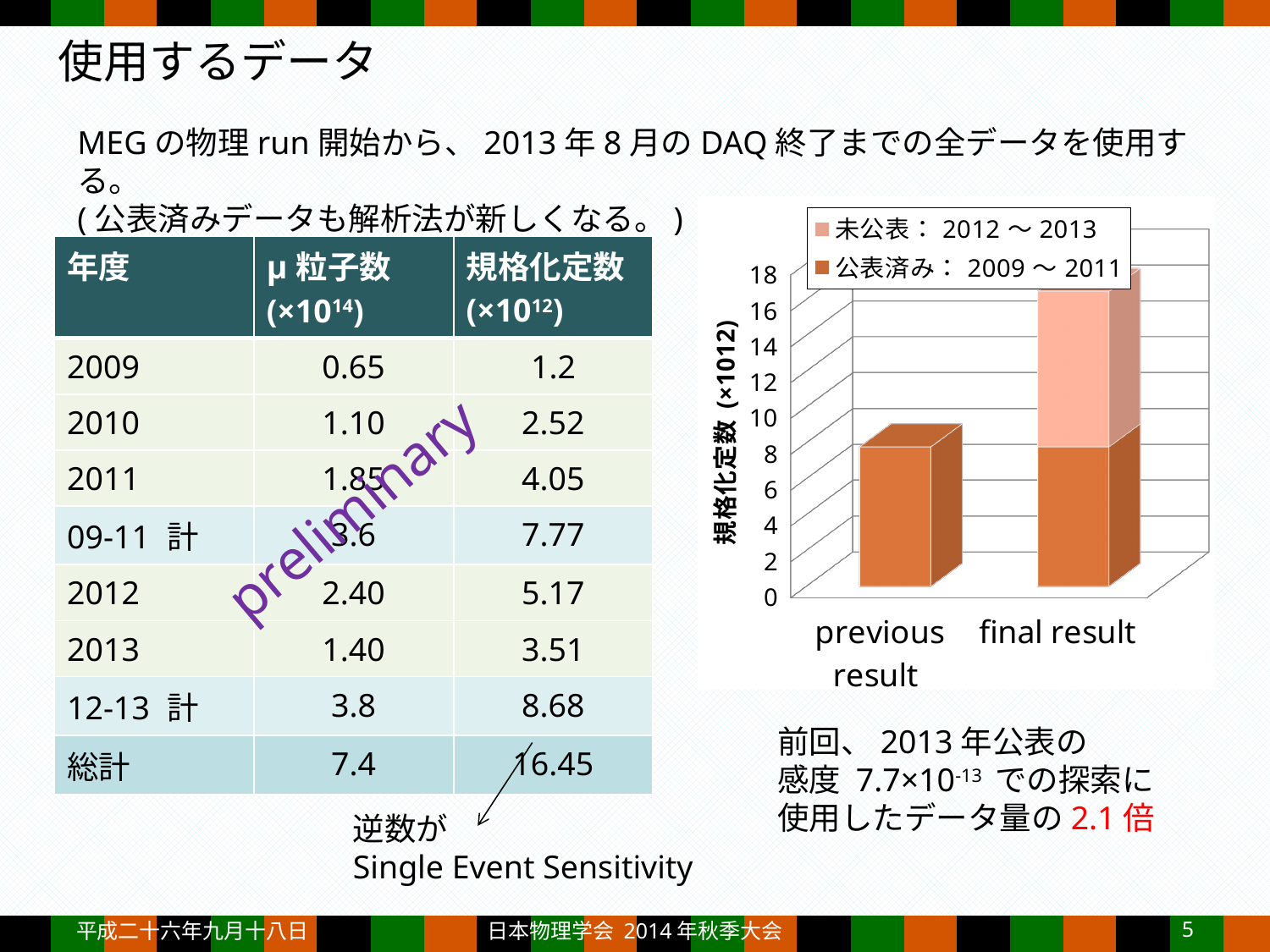
Is the 未公表: 2012～2013 segment of the final result bar greater or less than 4? greater Is the total bar for previous result greater or less than 6? greater Is the total bar for previous result greater or less than 10? less Which category has the shorter bar in the chart? previous result How many categories are shown on the x axis of the chart? 2 What is the label of the chart's vertical axis? 規格化定数 (×10^12) How many series does the chart's legend list? 2 Which category has the taller bar, previous result or final result? final result What kind of chart is shown on the slide? stacked bar chart Which legend entry is shown in the lighter colour? 未公表: 2012～2013